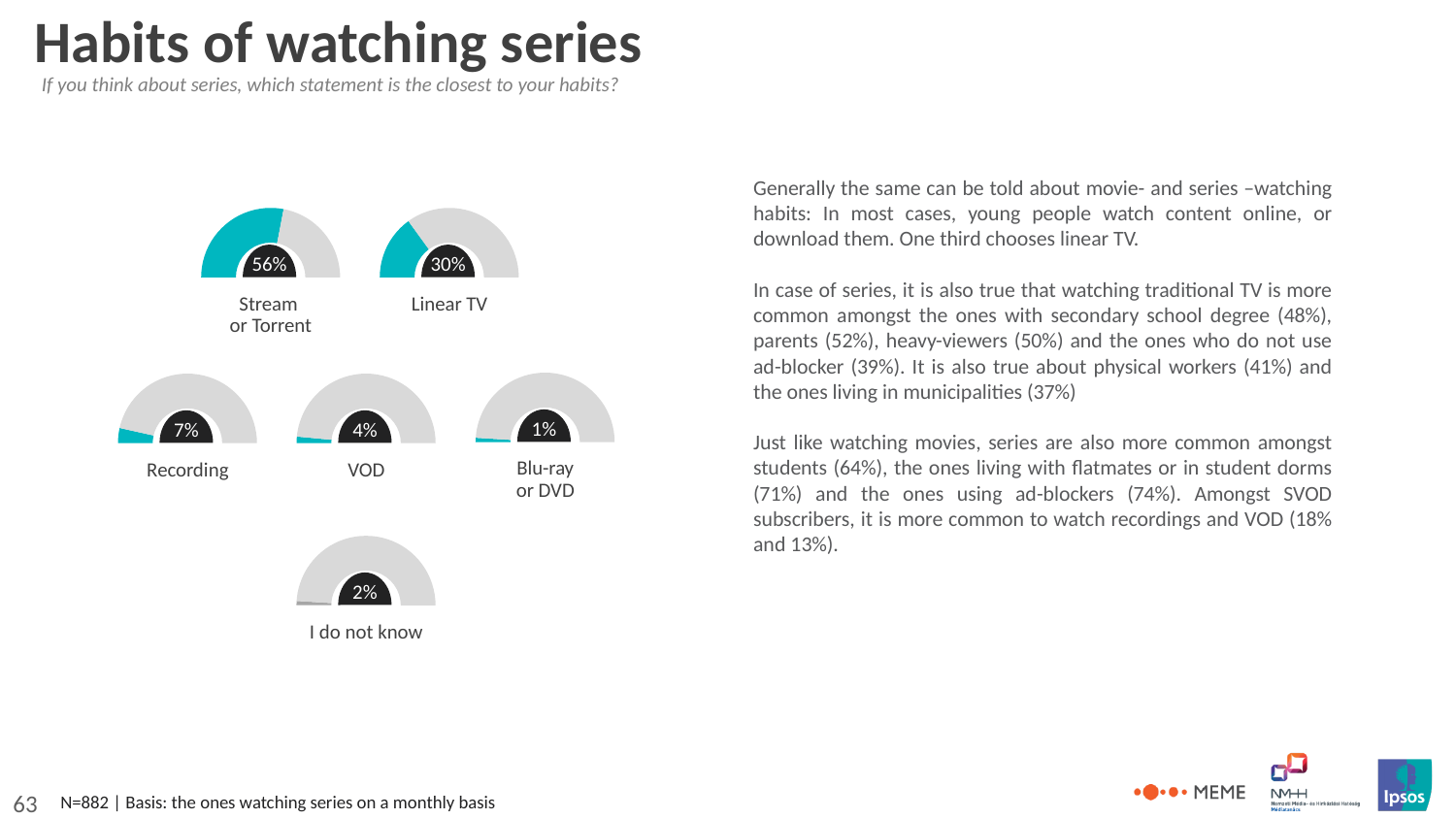
What percentage is shown for I do not know? 2% What percentage is shown for VOD? 4% What percentage is shown for Stream or Torrent? 56% What percentage is shown for Blu-ray or DVD? 1% What percentage is shown for Linear TV? 30% How many categories are shown in the gauge charts? 6 What percentage is shown for Recording? 7% What kind of charts are used to display the percentages on the slide? Gauge (semi-circle donut) charts Which is larger, the value for Recording or the value for VOD? Recording Which category has the highest percentage? Stream or Torrent What is the difference in percentage points between Stream or Torrent and Linear TV? 26 Which category has the lowest percentage? Blu-ray or DVD